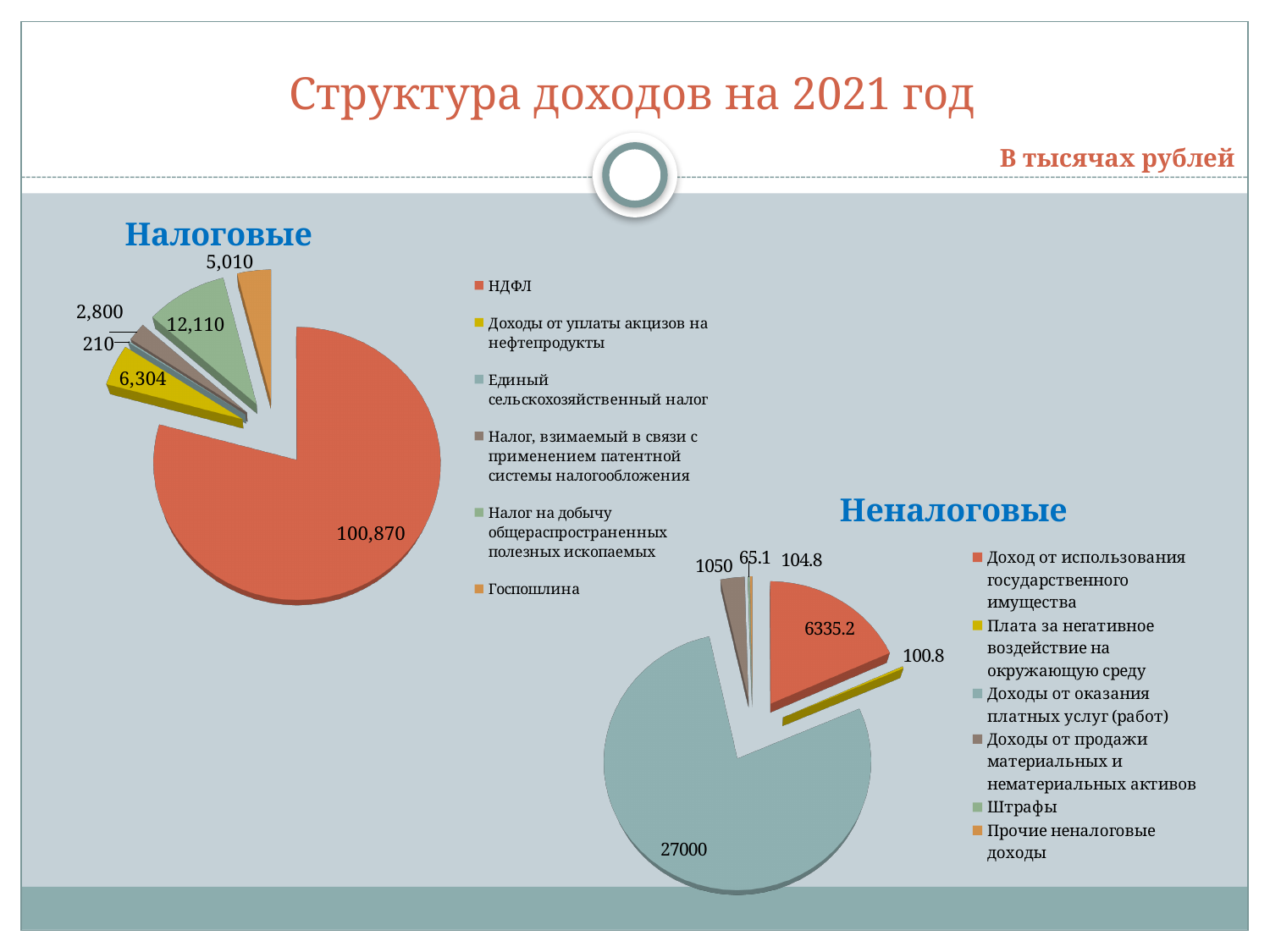
What unit is stated for the values on the slide? В тысячах рублей On the 'Неналоговые' chart, which is larger: Плата за негативное воздействие на окружающую среду or Прочие неналоговые доходы? Прочие неналоговые доходы On the 'Неналоговые' chart, what is the value for Доходы от оказания платных услуг (работ)? 27000 On the 'Неналоговые' chart, which category has the largest value? Доходы от оказания платных услуг (работ) On the 'Налоговые' chart, how many categories does the legend list? 6 On the 'Налоговые' chart, what is the difference between Налог на добычу общераспространенных полезных ископаемых and Доходы от уплаты акцизов на нефтепродукты? 5,806 What type of chart is used for 'Неналоговые'? Pie chart On the 'Налоговые' chart, what is the value for Госпошлина? 5,010 On the 'Налоговые' chart, what is the value for Единый сельскохозяйственный налог? 210 On the 'Налоговые' chart, which category has the smallest value? Единый сельскохозяйственный налог On the 'Неналоговые' chart, what is the value for Доходы от продажи материальных и нематериальных активов? 1050 On the 'Налоговые' chart, what is the value for НДФЛ? 100,870